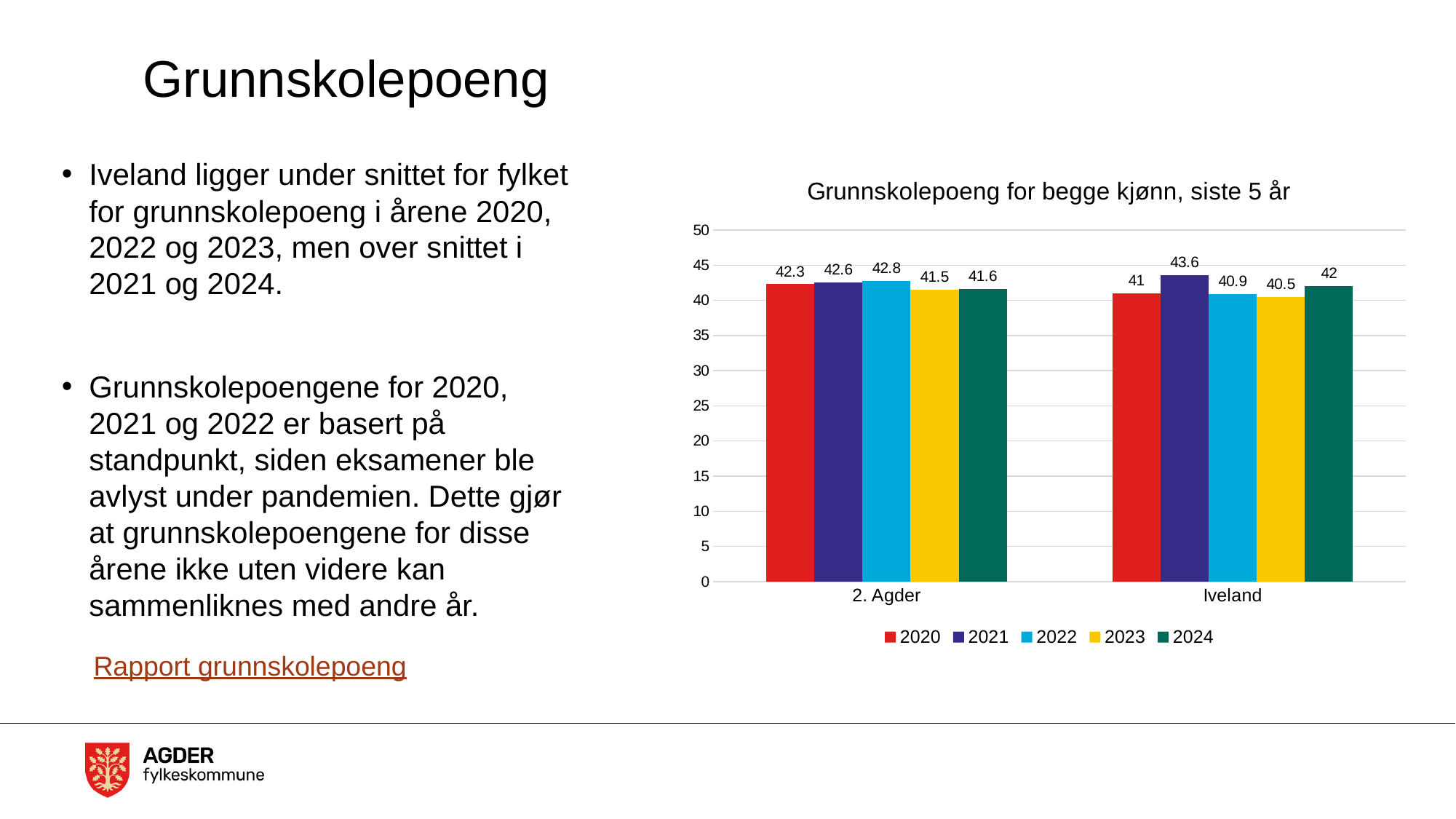
How many categories are shown on the x axis? 2 What is the value for 2. Agder in 2022? 42.8 What kind of chart is shown? Bar chart What is the value for 2. Agder in 2024? 41.6 What is the value for Iveland in 2023? 40.5 Which year has the lowest value for 2. Agder? 2023 What is the title of the chart? Grunnskolepoeng for begge kjønn, siste 5 år How many series does the legend list? 5 What is the difference between the 2021 values for Iveland and 2. Agder? 1 What is the value for Iveland in 2021? 43.6 Which is larger, the 2020 value for 2. Agder or the 2020 value for Iveland? 2. Agder Which year has the highest value for Iveland? 2021